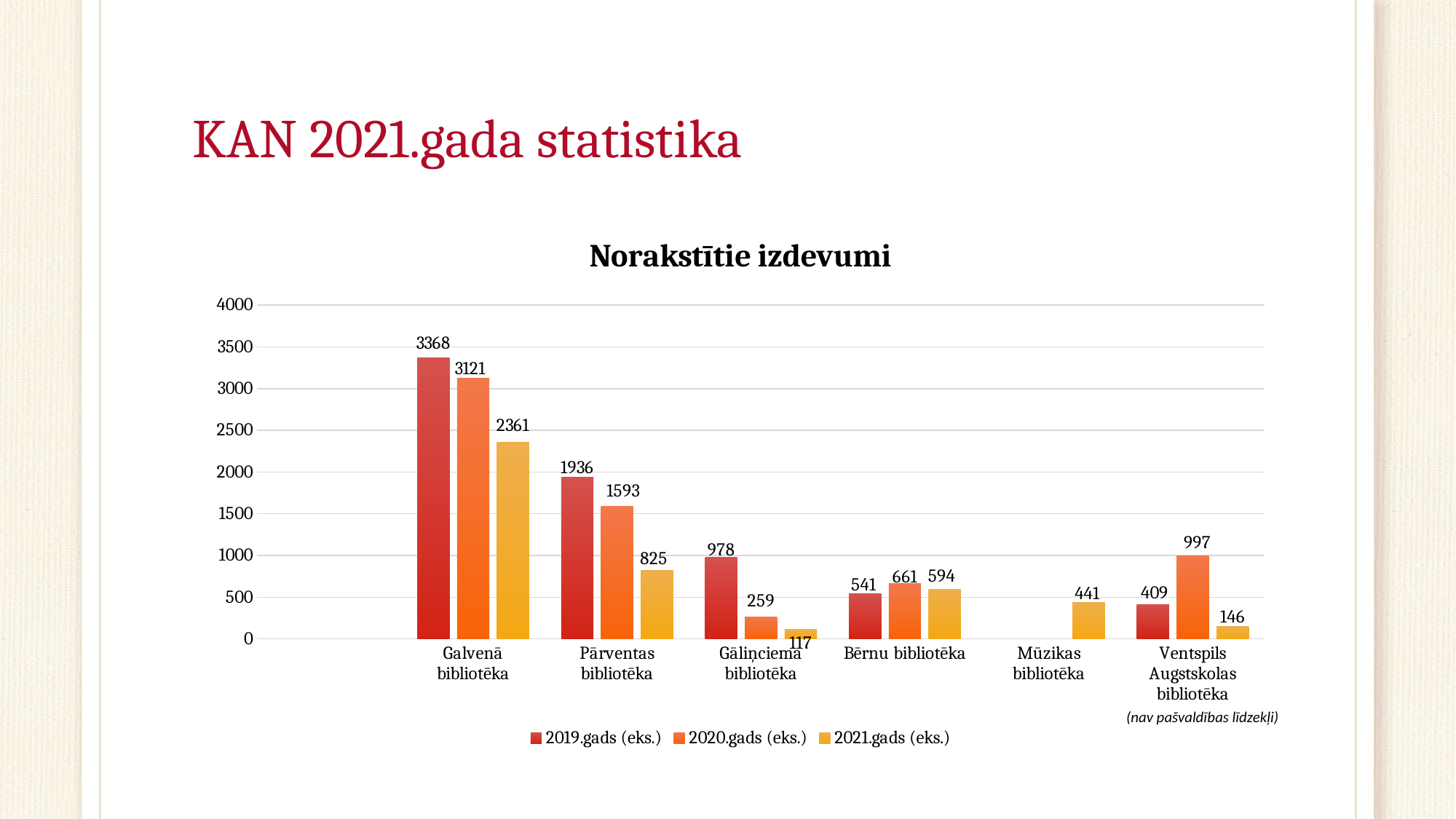
What is the value for Pārventas bibliotēka in the 2021.gads (eks.) series? 825 What is the value for Galvenā bibliotēka in the 2019.gads (eks.) series? 3368 What type of chart is shown on the slide? bar chart How many series does the legend list? 3 Do the values for Pārventas bibliotēka rise or fall from 2019.gads (eks.) to 2021.gads (eks.)? fall What is the title of the chart? Norakstītie izdevumi What is the value for Ventspils Augstskolas bibliotēka in the 2020.gads (eks.) series? 997 For Bērnu bibliotēka, which is larger: the 2020.gads (eks.) value or the 2021.gads (eks.) value? 2020.gads (eks.) Which library has the lowest value in the 2021.gads (eks.) series? Gāliņciema bibliotēka Which library has the highest value in the 2021.gads (eks.) series? Galvenā bibliotēka What is the difference between the 2019.gads (eks.) and 2020.gads (eks.) values for Gāliņciema bibliotēka? 719 How many library categories are shown on the x axis? 6